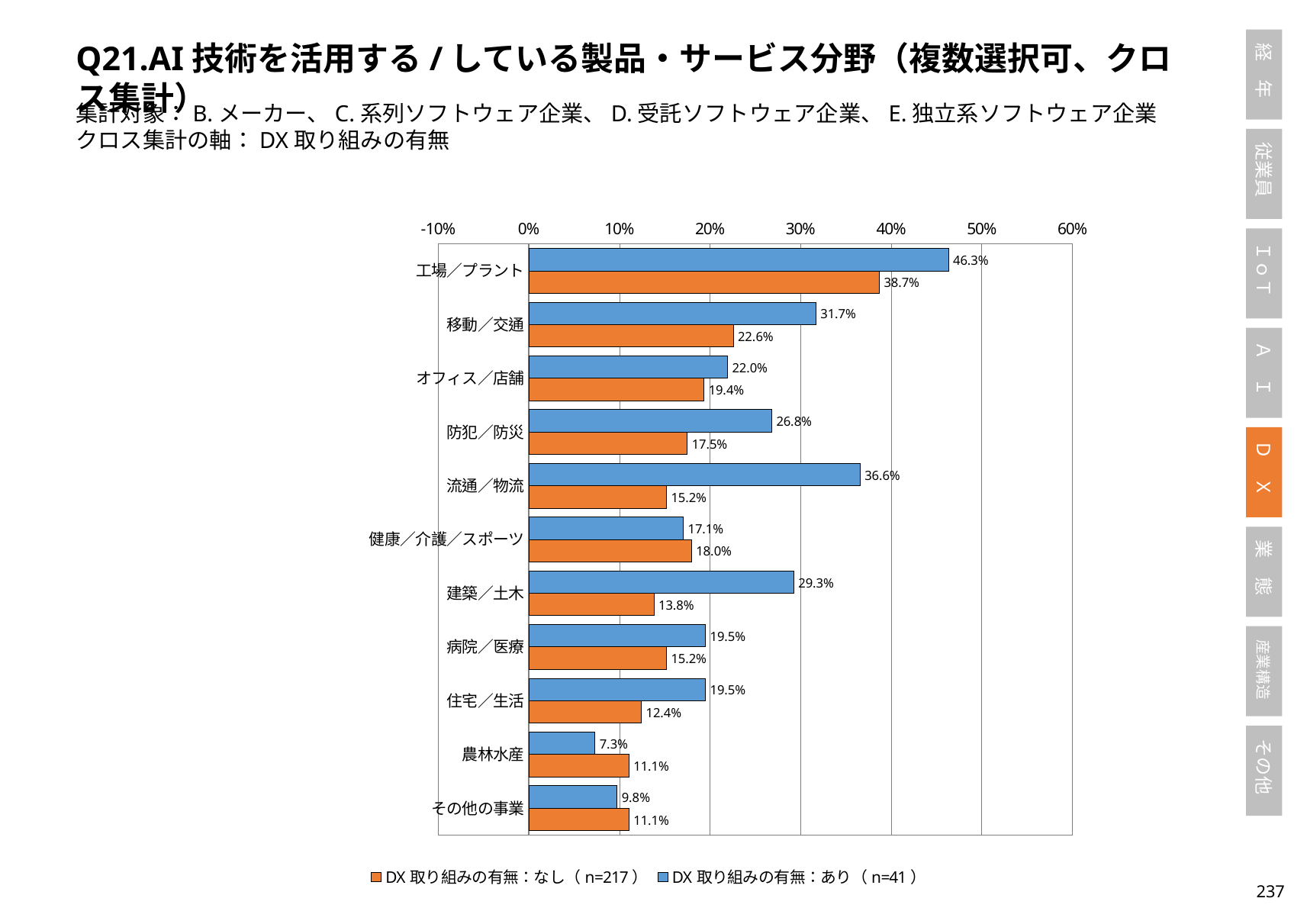
What kind of chart is shown on the slide? bar chart What is the value for 建築／土木 in the DX取り組みの有無：あり（n=41） series? 29.3% What is the value for 工場／プラント in the DX取り組みの有無：あり（n=41） series? 46.3% What is the difference between the DX取り組みの有無：あり（n=41） and DX取り組みの有無：なし（n=217） values for 流通／物流? 21.4% What is the value for 流通／物流 in the DX取り組みの有無：なし（n=217） series? 15.2% How many series does the legend list? 2 For 農林水産, which series has the larger value: DX取り組みの有無：あり（n=41） or DX取り組みの有無：なし（n=217）? DX取り組みの有無：なし（n=217） Which category has the highest value in the DX取り組みの有無：なし（n=217） series? 工場／プラント Which category has the lowest value in the DX取り組みの有無：あり（n=41） series? 農林水産 Is the value for 移動／交通 in the DX取り組みの有無：あり（n=41） series greater or less than 30%? greater What colour represents the DX取り組みの有無：あり（n=41） series? blue How many categories are shown on the chart? 11